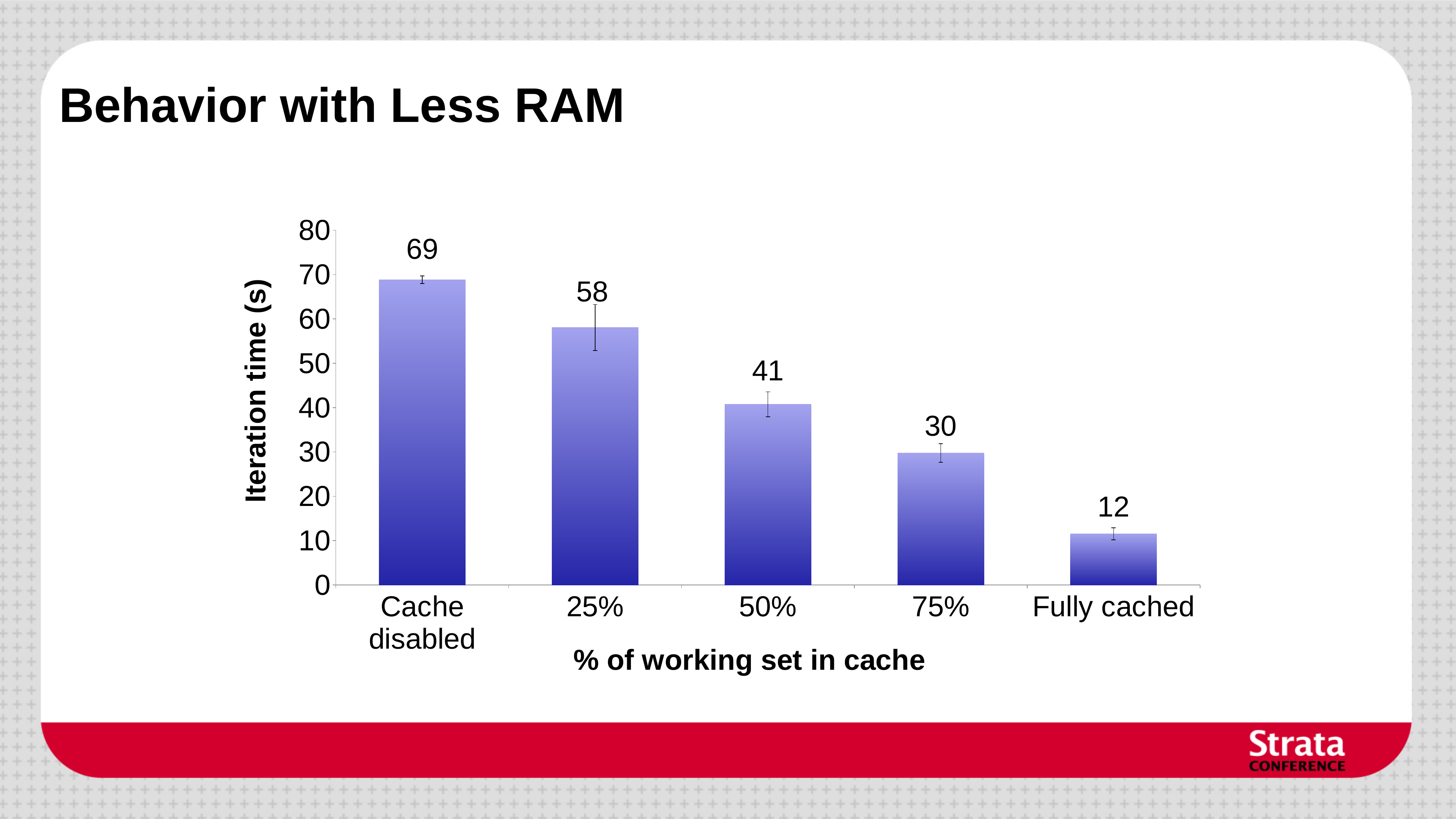
What is the difference in iteration time between 25% and 75% of the working set in cache? 28 Which category has the highest iteration time? Cache disabled How many categories are shown on the x axis? 5 What is the difference in iteration time between Cache disabled and Fully cached? 57 Which has a larger iteration time, 25% or 50% of the working set in cache? 25% Do the iteration times rise or fall as the percentage of the working set in cache increases along the x axis? fall Which category has the lowest iteration time? Fully cached What kind of chart is shown on the slide? bar chart What is the iteration time when the working set is fully cached? 12 Is the iteration time for 75% greater or less than 40? less What is the iteration time when 50% of the working set is in cache? 41 What is the iteration time when the cache is disabled? 69